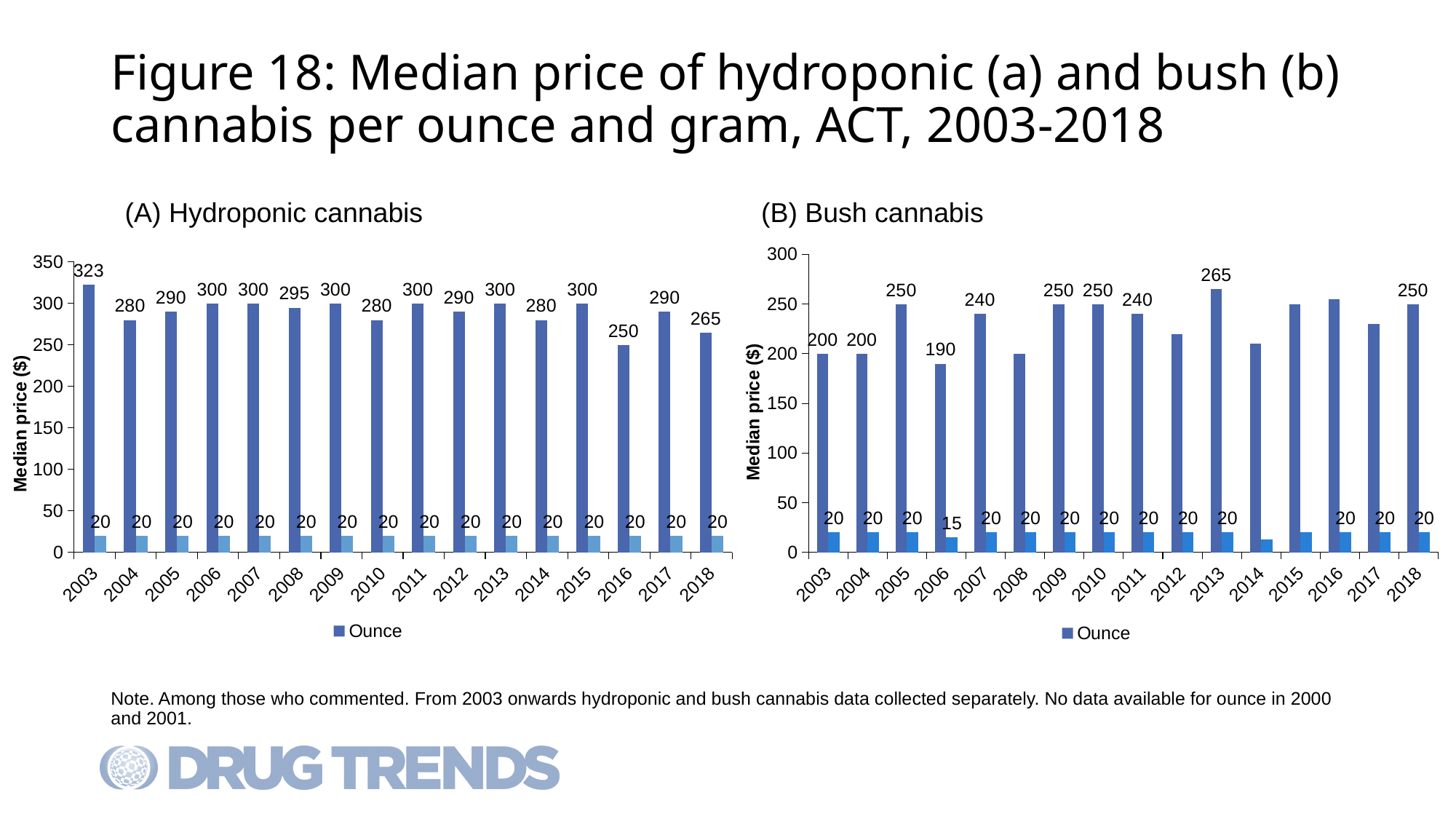
In the (A) Hydroponic cannabis chart, what is the median price per ounce in 2003? 323 In the (B) Bush cannabis chart, what is the difference between the ounce price in 2013 and in 2006? 75 In the (B) Bush cannabis chart, what is the median price per ounce in 2013? 265 In the (A) Hydroponic cannabis chart, which is larger, the ounce price in 2004 or in 2005? 2005 In the (A) Hydroponic cannabis chart, which year has the lowest median price per ounce? 2016 In the (A) Hydroponic cannabis chart, what is the difference between the ounce price in 2003 and in 2016? 73 In the (B) Bush cannabis chart, what is the median price per gram in 2006? 15 In the (A) Hydroponic cannabis chart, which year has the highest median price per ounce? 2003 What kind of chart is the (B) Bush cannabis chart? bar chart In the (A) Hydroponic cannabis chart, what is the median price per gram in 2010? 20 In the (B) Bush cannabis chart, is the ounce price for 2012 greater or less than 200? greater How many years are shown on the x axis of the (A) Hydroponic cannabis chart? 16